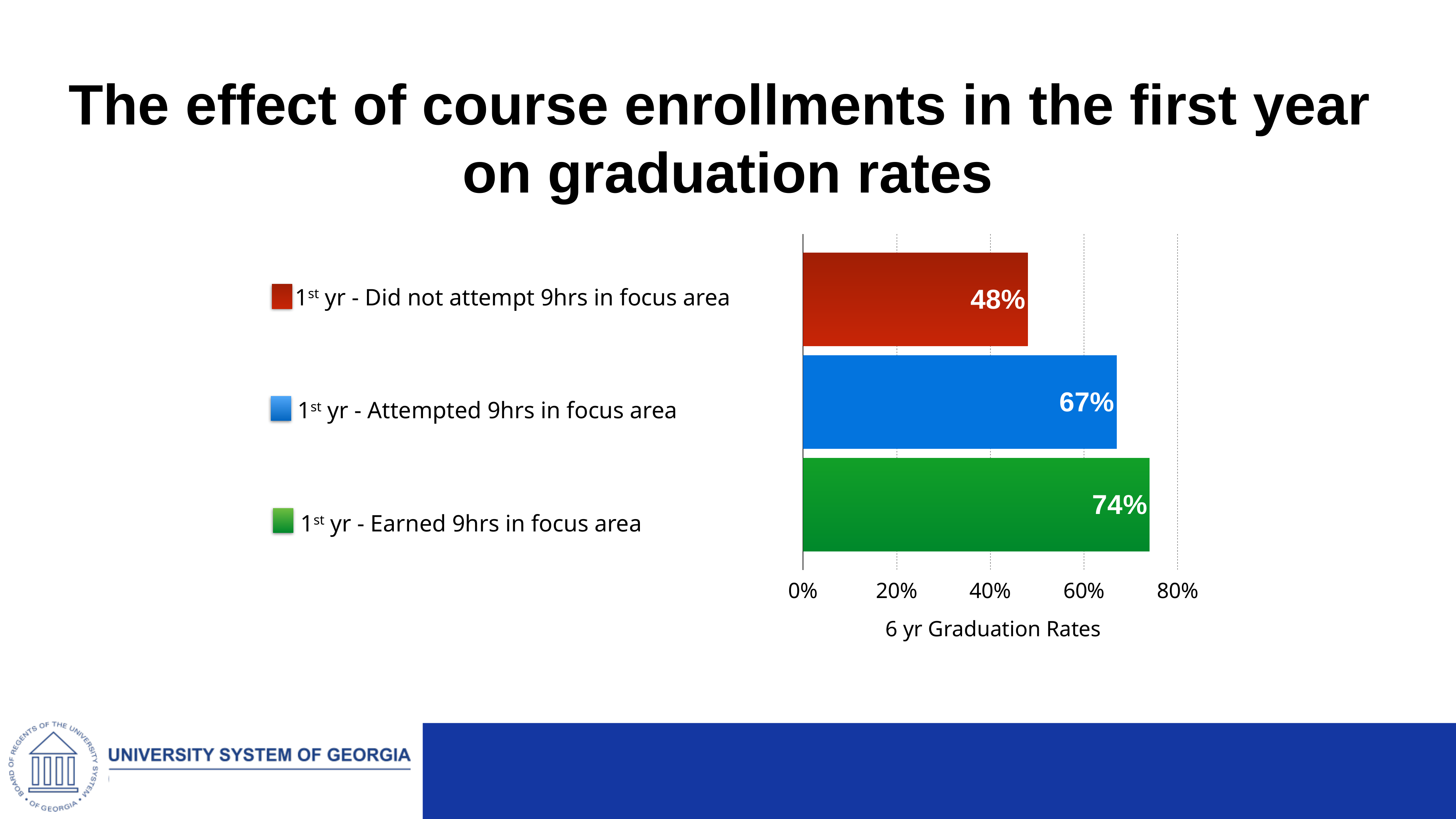
Which group has the highest 6 yr graduation rate? 1st yr - Earned 9hrs in focus area Is the 6 yr graduation rate for students who did not attempt 9hrs in the focus area greater or less than 60%? less Which group has the lowest 6 yr graduation rate? 1st yr - Did not attempt 9hrs in focus area What is the difference in 6 yr graduation rate between students who earned 9hrs and those who attempted 9hrs in the focus area? 7% How many groups are shown in the chart? 3 What is the label on the horizontal axis of the chart? 6 yr Graduation Rates What is the 6 yr graduation rate for students who did not attempt 9hrs in the focus area in the 1st yr? 48% What is the 6 yr graduation rate for students who earned 9hrs in the focus area in the 1st yr? 74% What kind of chart is shown on the slide? Bar chart Which group has a higher 6 yr graduation rate: those who attempted 9hrs or those who did not attempt 9hrs in the focus area? 1st yr - Attempted 9hrs in focus area What is the difference in 6 yr graduation rate between students who earned 9hrs and those who did not attempt 9hrs in the focus area? 26% What is the 6 yr graduation rate for students who attempted 9hrs in the focus area in the 1st yr? 67%